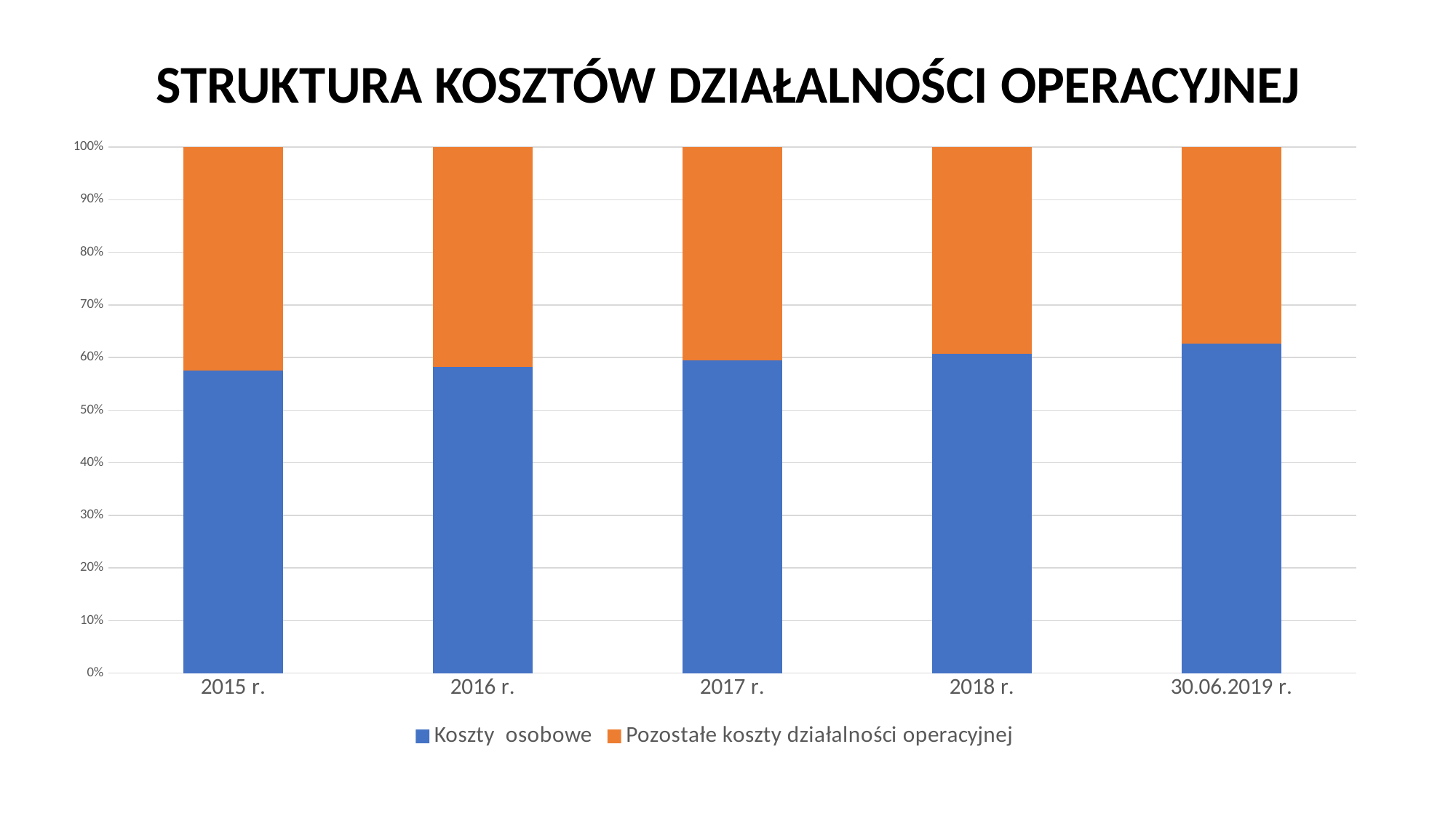
What is the title of the chart? STRUKTURA KOSZTÓW DZIAŁALNOŚCI OPERACYJNEJ Is the share of Pozostałe koszty działalności operacyjnej in 2015 r. greater or less than 40%? greater Which series is shown in orange? Pozostałe koszty działalności operacyjnej Is the share of Koszty osobowe in 30.06.2019 r. greater or less than 60%? greater In which period is the share of Pozostałe koszty działalności operacyjnej the lowest? 30.06.2019 r. What kind of chart is shown on the slide? Stacked bar chart Is the share of Koszty osobowe in 2015 r. greater or less than 60%? less How many categories (periods) are shown on the x axis? 5 In which period is the share of Koszty osobowe the highest? 30.06.2019 r. Does the share of Koszty osobowe rise or fall from 2015 r. to 30.06.2019 r.? rise What is the total height of the stacked bar for 2015 r.? 100% How many series does the legend list? 2